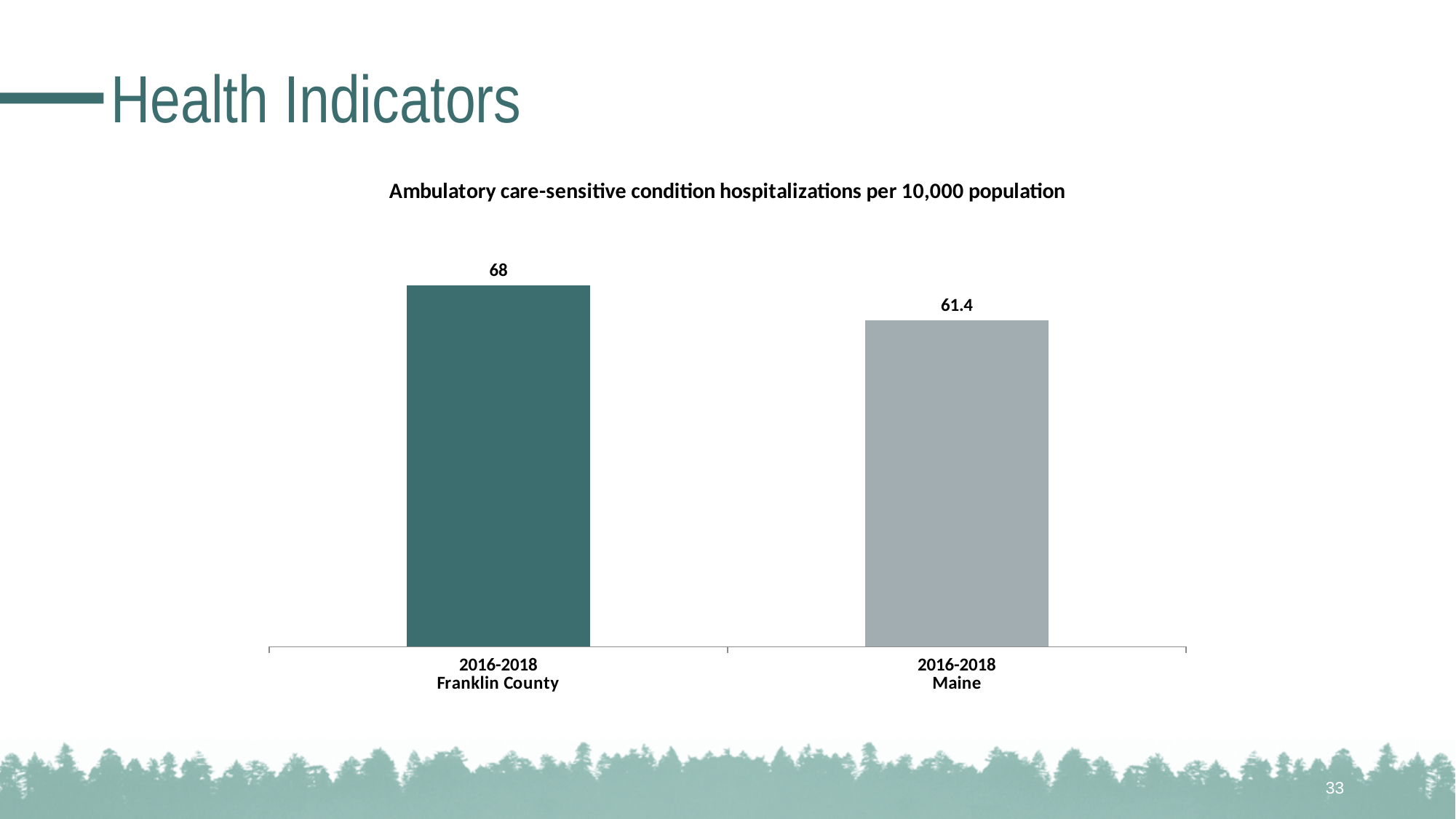
How many bars are shown in the chart? 2 What is the difference between the Franklin County value and the Maine value? 6.6 Which category has the highest value? Franklin County What time period do both bars cover? 2016-2018 What is the value for Maine (2016-2018)? 61.4 What is the value for Franklin County (2016-2018)? 68 What is the title of the chart? Ambulatory care-sensitive condition hospitalizations per 10,000 population Which category has the lowest value? Maine Which is larger, the value for Franklin County or the value for Maine? Franklin County What kind of chart is shown on the slide? Bar chart